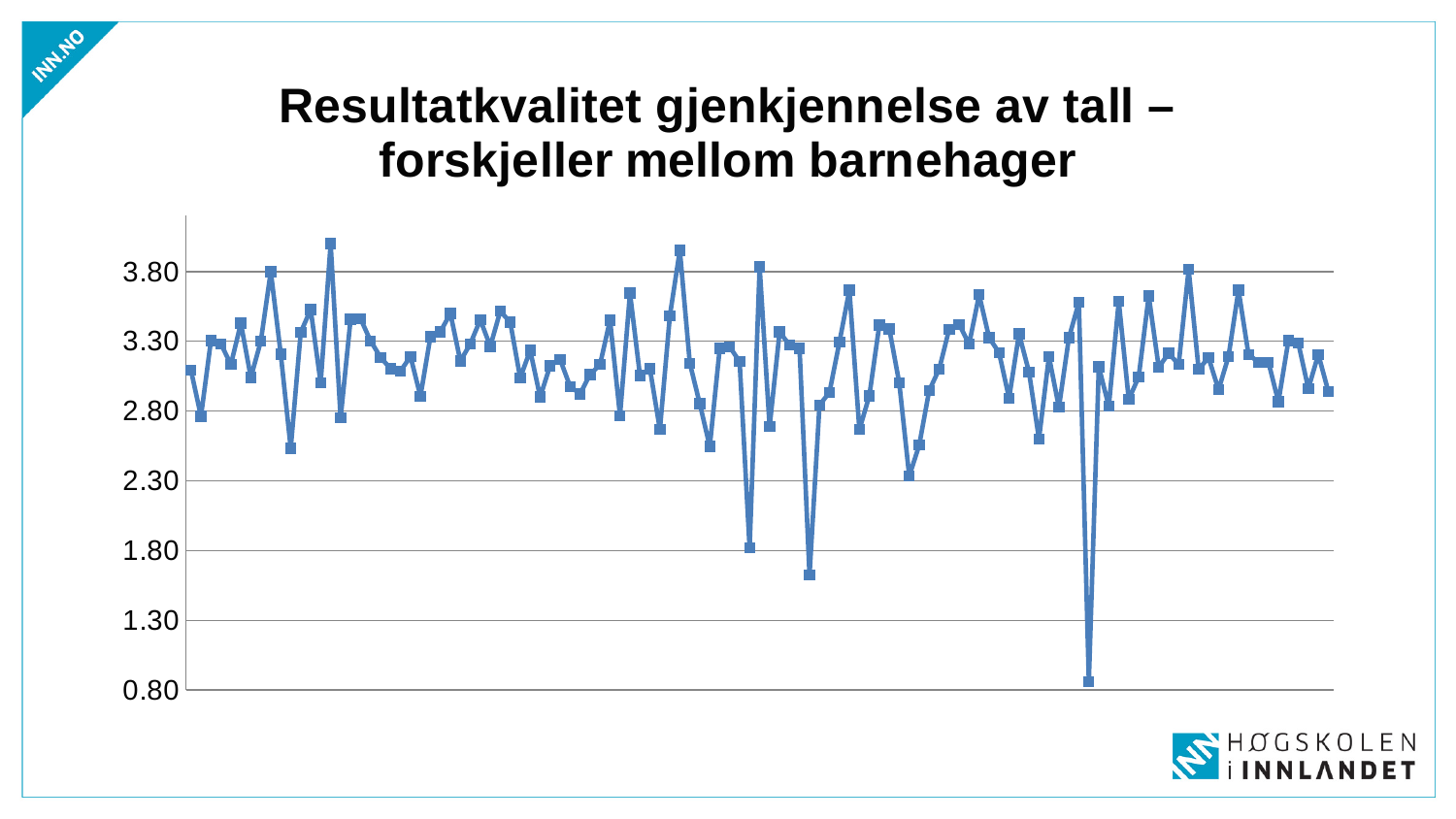
What is the lowest value shown on the vertical axis? 0.80 Is the lowest point on the line greater or less than 1.30? less What kind of chart is shown on the slide? line chart What is the title of the chart on the slide? Resultatkvalitet gjenkjennelse av tall – forskjeller mellom barnehager Is the highest point on the line greater or less than 3.80? greater How many lines are plotted on the chart? 1